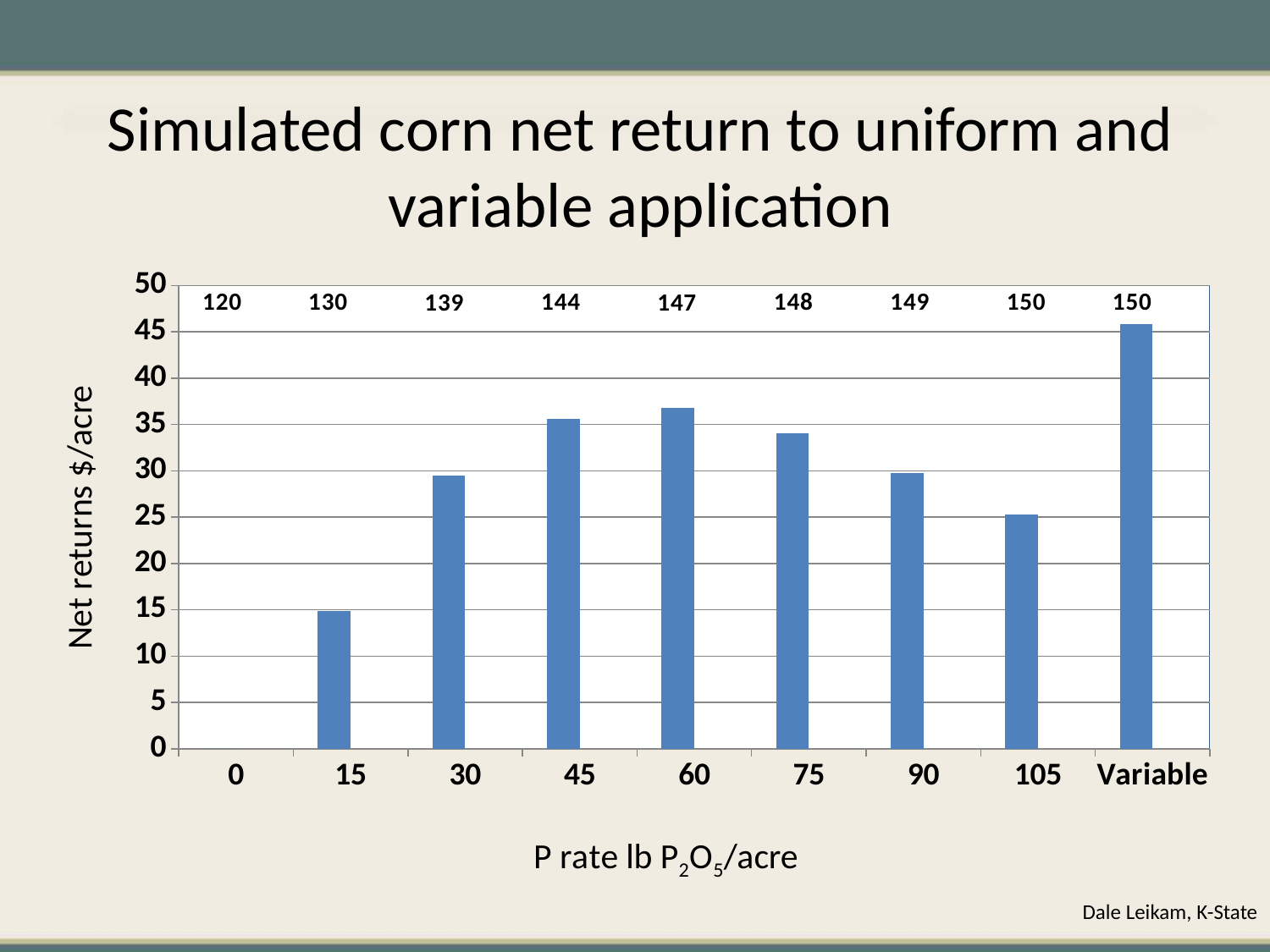
Is the net return for the 15 lb P rate greater or less than 20? less How many categories are shown on the x axis of the chart? 9 What is the title of the chart? Simulated corn net return to uniform and variable application Is the net return for the Variable category greater or less than 45? greater Is the net return for the 60 lb P rate greater or less than 35? greater What is the label of the y axis? Net returns $/acre What kind of chart is shown on the slide? bar chart Which has the larger net return, the 15 lb P rate or the 45 lb P rate? 45 Which category has the highest net return? Variable Which has the larger net return, the 75 lb P rate or the 105 lb P rate? 75 Do the net returns rise or fall as the P rate increases from 60 to 105? fall